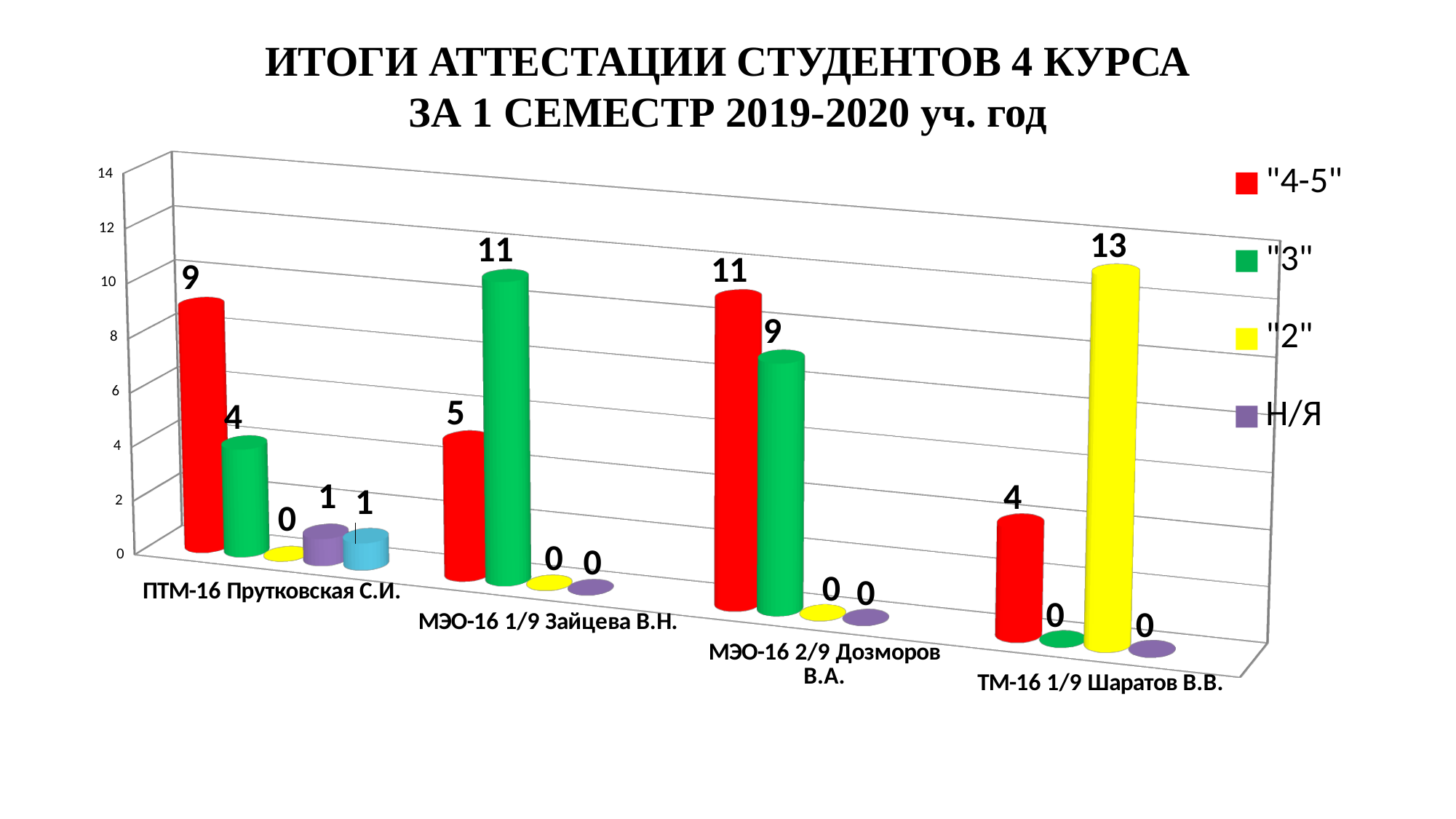
Which group has the highest value in the "4-5" series? МЭО-16 2/9 Дозморов В.А. What is the difference between the "3" value and the "4-5" value for МЭО-16 1/9 Зайцева В.Н.? 6 What is the title of the chart? ИТОГИ АТТЕСТАЦИИ СТУДЕНТОВ 4 КУРСА ЗА 1 СЕМЕСТР 2019-2020 уч. год How many groups (categories) are shown on the x axis? 4 Which group has the lowest value in the "4-5" series? ТМ-16 1/9 Шаратов В.В. For ПТМ-16 Прутковская С.И., which is larger: the "4-5" value or the "3" value? "4-5" What kind of chart is shown on the slide? bar chart What is the value of the "3" series for МЭО-16 1/9 Зайцева В.Н.? 11 What is the value of the "2" series for ТМ-16 1/9 Шаратов В.В.? 13 What is the value of the "4-5" series for МЭО-16 2/9 Дозморов В.А.? 11 How many series does the legend list? 4 What is the value of the "4-5" series for ПТМ-16 Прутковская С.И.? 9